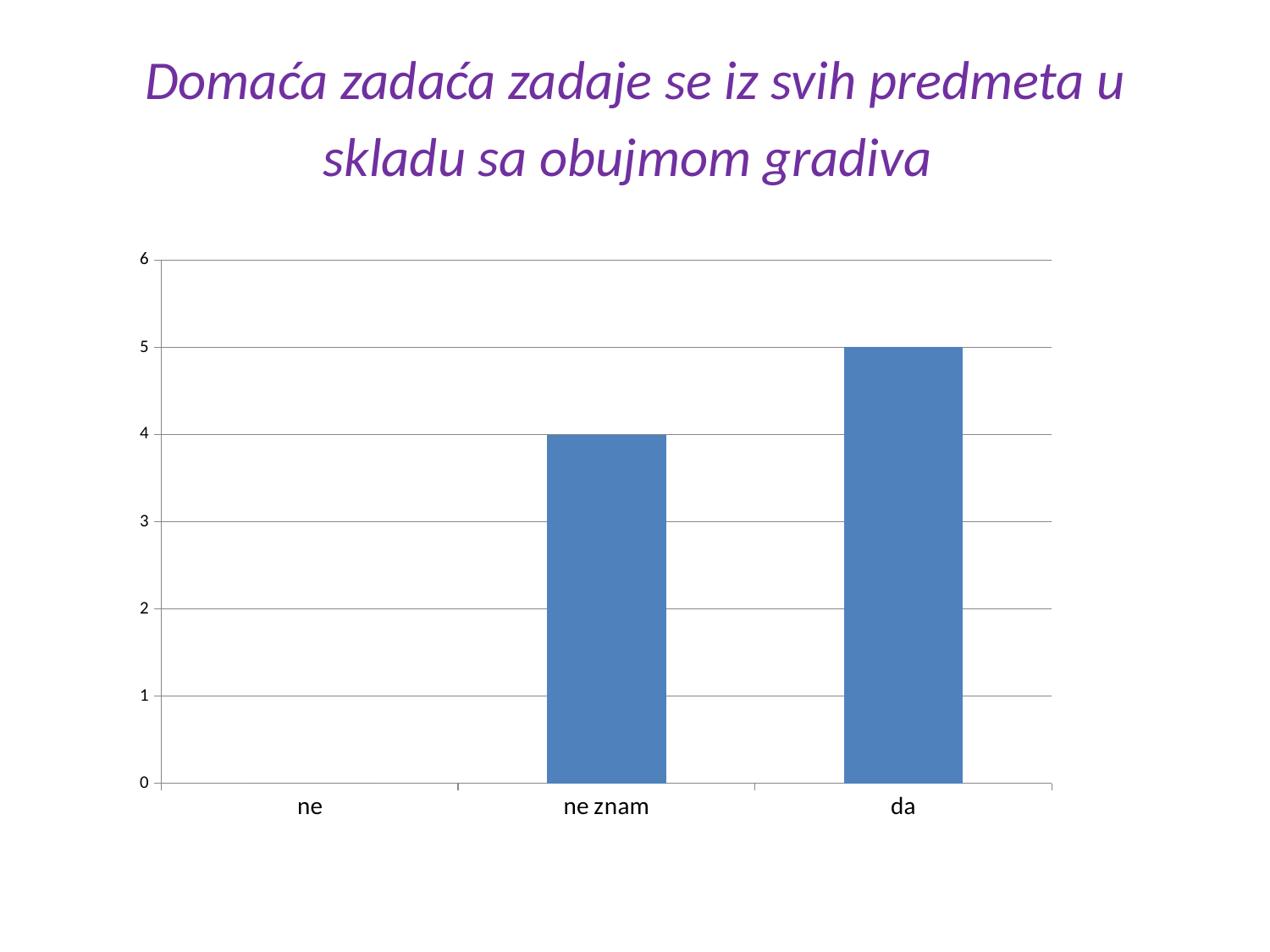
Which is larger, the value for "ne znam" or the value for "da"? da Which category has the highest value? da What is the value for "ne znam"? 4 What is the value for "ne"? 0 Is the value for "da" greater or less than 3? greater What kind of chart is shown on the slide? bar chart Do the values rise or fall from left to right along the x axis? rise Which category has the lowest value? ne What is the value for "da"? 5 What is the maximum value shown on the vertical axis? 6 How many categories are shown on the x axis of the chart? 3 What is the difference between the values for "da" and "ne znam"? 1